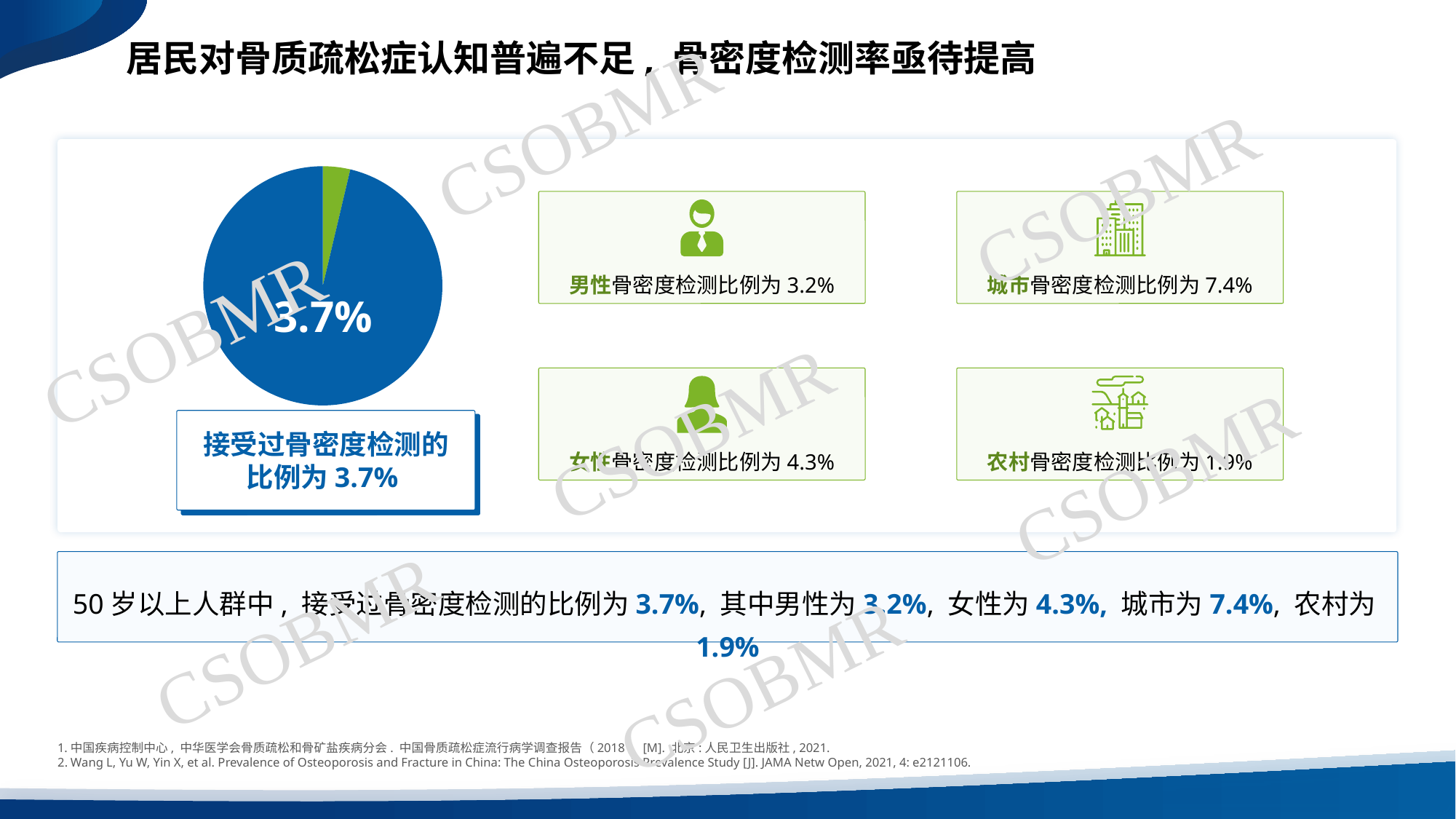
What share of the pie is taken by the blue slice? 96.3% What share of the pie does the small green slice represent? 3.7% What kind of chart is shown on the left of the slide? pie chart What colour is the small slice of the pie chart? green What value is printed as the data label on the pie chart? 3.7% What does the caption box below the pie chart say? 接受过骨密度检测的比例为 3.7% Which slice of the pie chart is larger, the blue one or the green one? the blue one How many slices does the pie chart have? 2